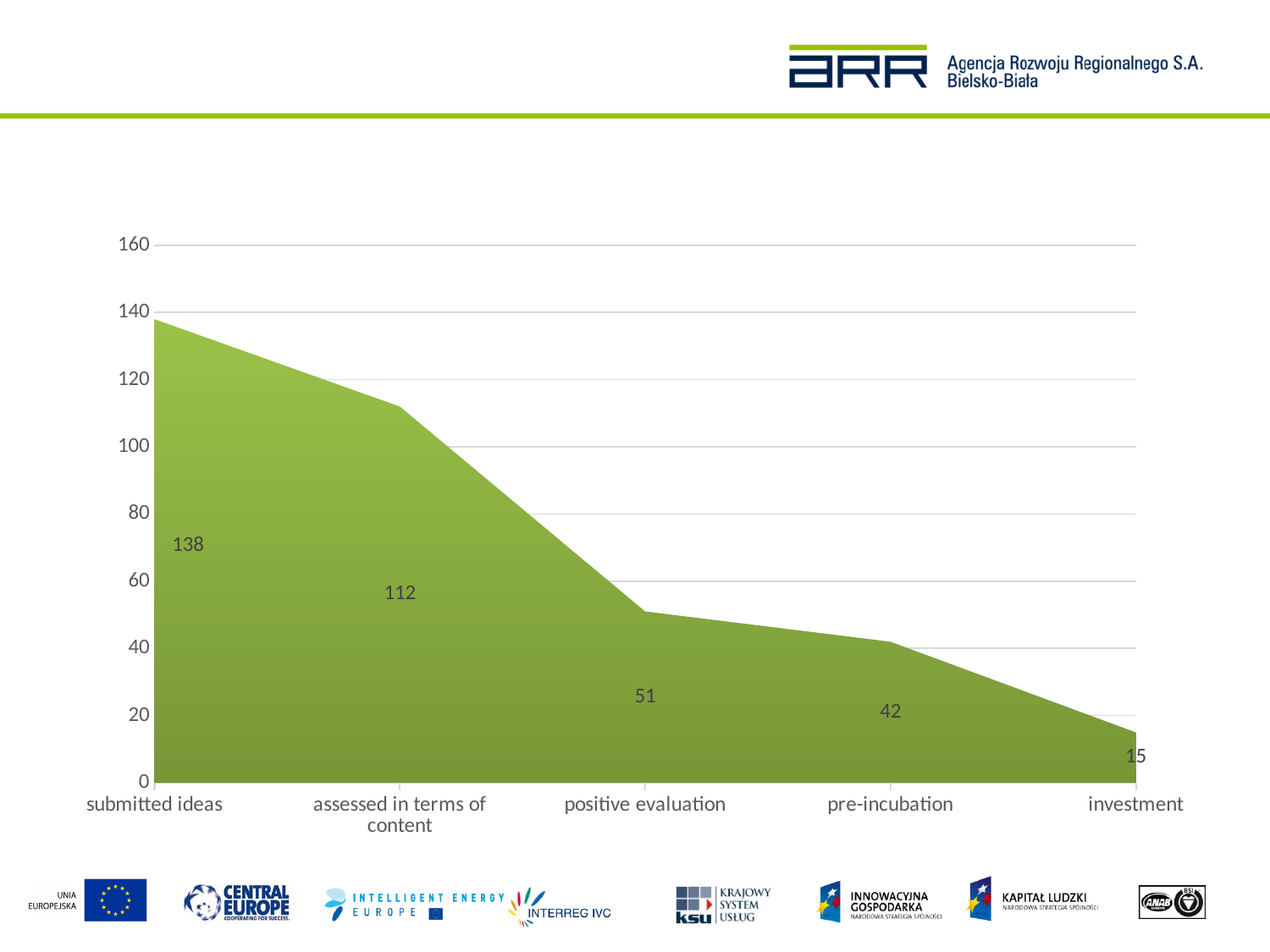
What is the value for investment? 15 Which category has the lowest value? investment Which category has the highest value? submitted ideas What is the value for assessed in terms of content? 112 What is the value for positive evaluation? 51 Do the values rise or fall from left to right along the x axis? fall What is the value for pre-incubation? 42 What is the difference between the values for submitted ideas and assessed in terms of content? 26 What is the value for submitted ideas? 138 How many categories are shown on the x axis? 5 Which is larger, the value for positive evaluation or the value for investment? positive evaluation What is the difference between the values for positive evaluation and pre-incubation? 9